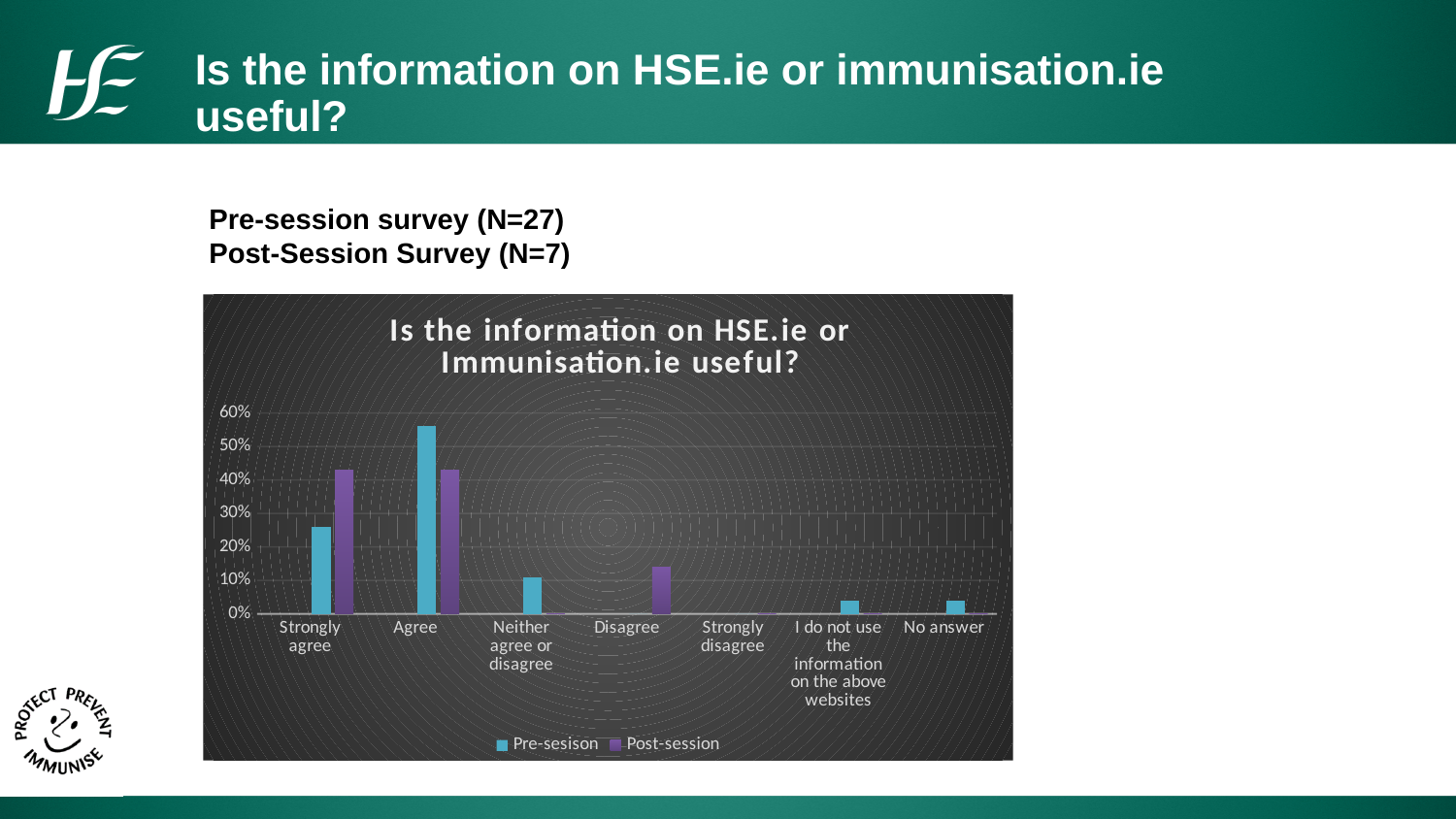
Which is larger for Agree: the Pre-session value or the Post-session value? Pre-session What kind of chart is shown on the slide? bar chart How many series does the chart legend list? 2 How many response categories are shown along the x axis of the chart? 7 Is the Post-session value for Strongly agree greater or less than 40%? greater Is the Post-session value for Disagree greater or less than 10%? greater Which category has the highest Pre-session value? Agree What are the two series named in the chart legend? Pre-sesison and Post-session Is the Pre-session value for Agree greater or less than 50%? greater What is the title of the chart? Is the information on HSE.ie or Immunisation.ie useful? Which is larger for Strongly agree: the Pre-session value or the Post-session value? Post-session